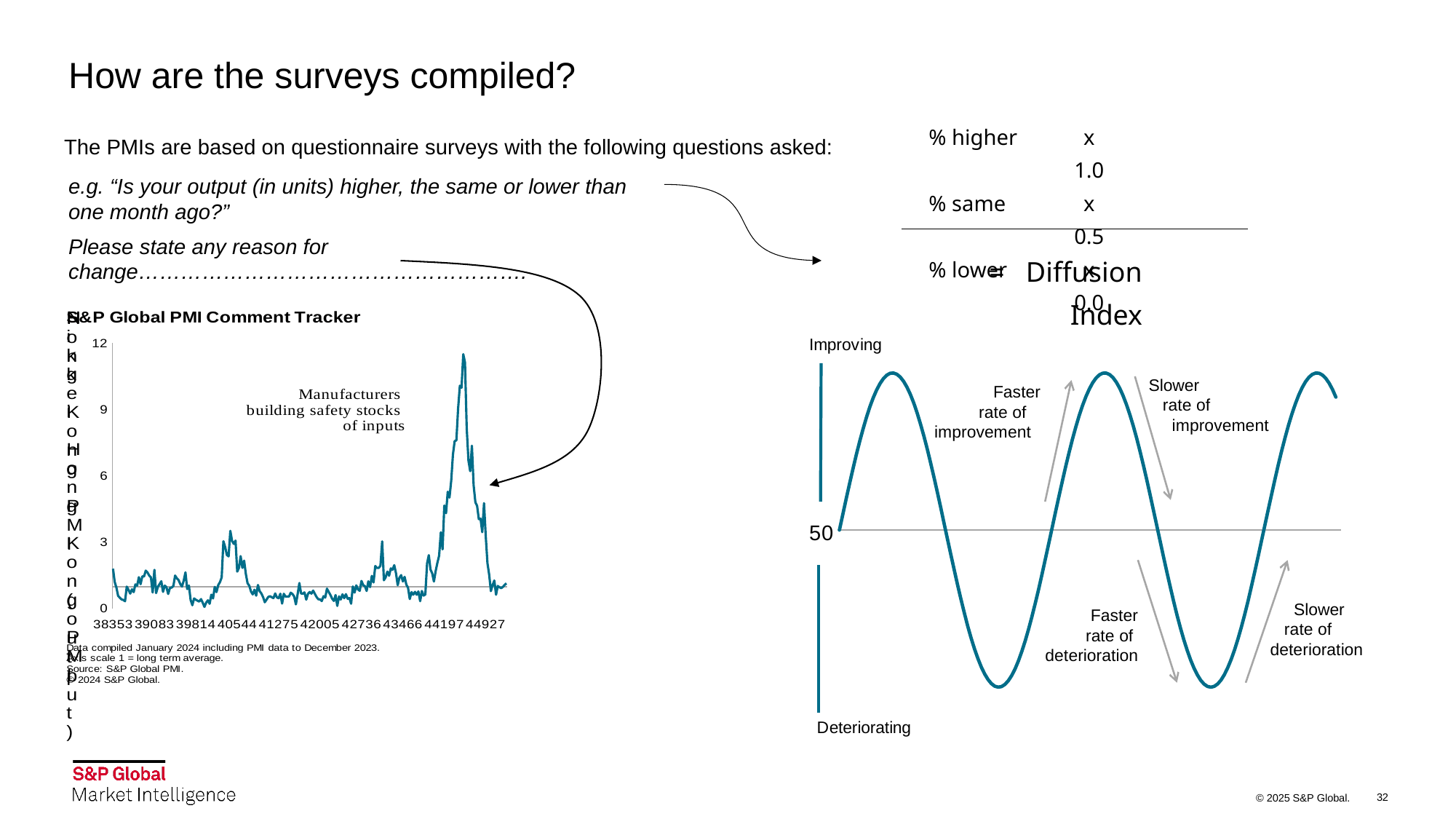
How many tick labels are shown on the x axis of the S&P Global PMI Comment Tracker chart? 10 In the S&P Global PMI Comment Tracker chart, is the peak near the x-axis tick 40544 higher or lower than the peak near the tick 44197? lower What is the title of the chart on the left of the slide? S&P Global PMI Comment Tracker What is the first tick label on the x axis of the S&P Global PMI Comment Tracker chart? 38353 In the S&P Global PMI Comment Tracker chart, what annotation text is placed near the tallest peak of the line? Manufacturers building safety stocks of inputs What kind of chart is the S&P Global PMI Comment Tracker chart? line chart In the S&P Global PMI Comment Tracker chart, is the value at the x-axis tick 40544 greater or less than 6? less What is the highest tick value shown on the y axis of the S&P Global PMI Comment Tracker chart? 12 In the S&P Global PMI Comment Tracker chart, is the highest peak of the line greater or less than 9? greater In the S&P Global PMI Comment Tracker chart, does the line rise or fall between the x-axis ticks 44197 and 44927 after its peak? fall What is the last tick label on the x axis of the S&P Global PMI Comment Tracker chart? 44927 In the S&P Global PMI Comment Tracker chart, is the value at the x-axis tick 42005 greater or less than 3? less